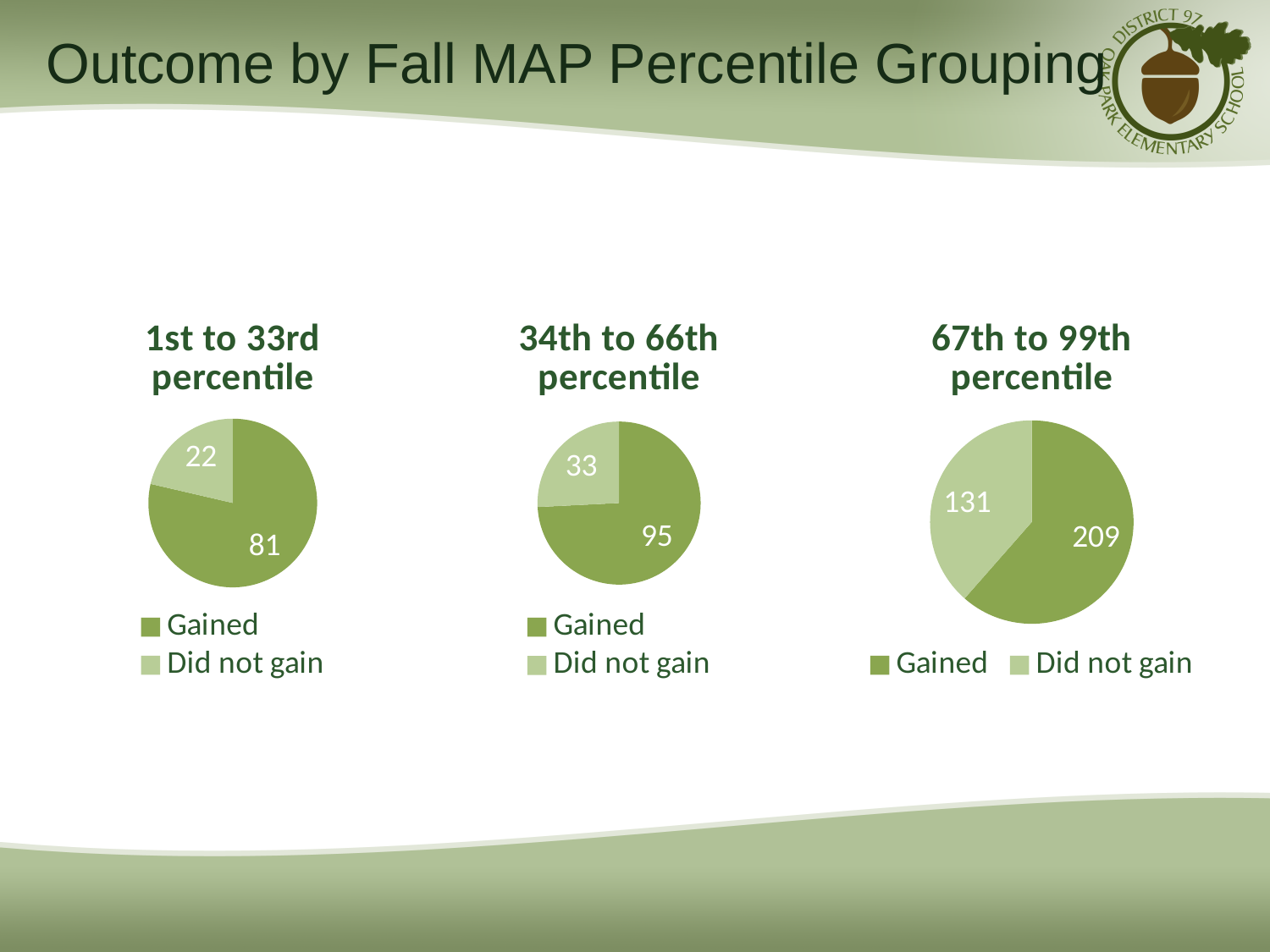
In the '67th to 99th percentile' chart, what is the difference between Gained and Did not gain? 78 What kind of chart is the '67th to 99th percentile' chart? Pie chart In the '67th to 99th percentile' chart, what is the value for Gained? 209 In the '34th to 66th percentile' chart, which slice is larger, Gained or Did not gain? Gained In the '1st to 33rd percentile' chart, what is the value for Did not gain? 22 In the '1st to 33rd percentile' chart, what is the total of Gained and Did not gain? 103 In the '67th to 99th percentile' chart, what is the value for Did not gain? 131 How many slices does the '34th to 66th percentile' pie chart have? 2 In the '1st to 33rd percentile' chart, what is the value for Gained? 81 What are the two legend entries shown under the '1st to 33rd percentile' chart? Gained and Did not gain In the '34th to 66th percentile' chart, what is the value for Gained? 95 In the '34th to 66th percentile' chart, what is the value for Did not gain? 33